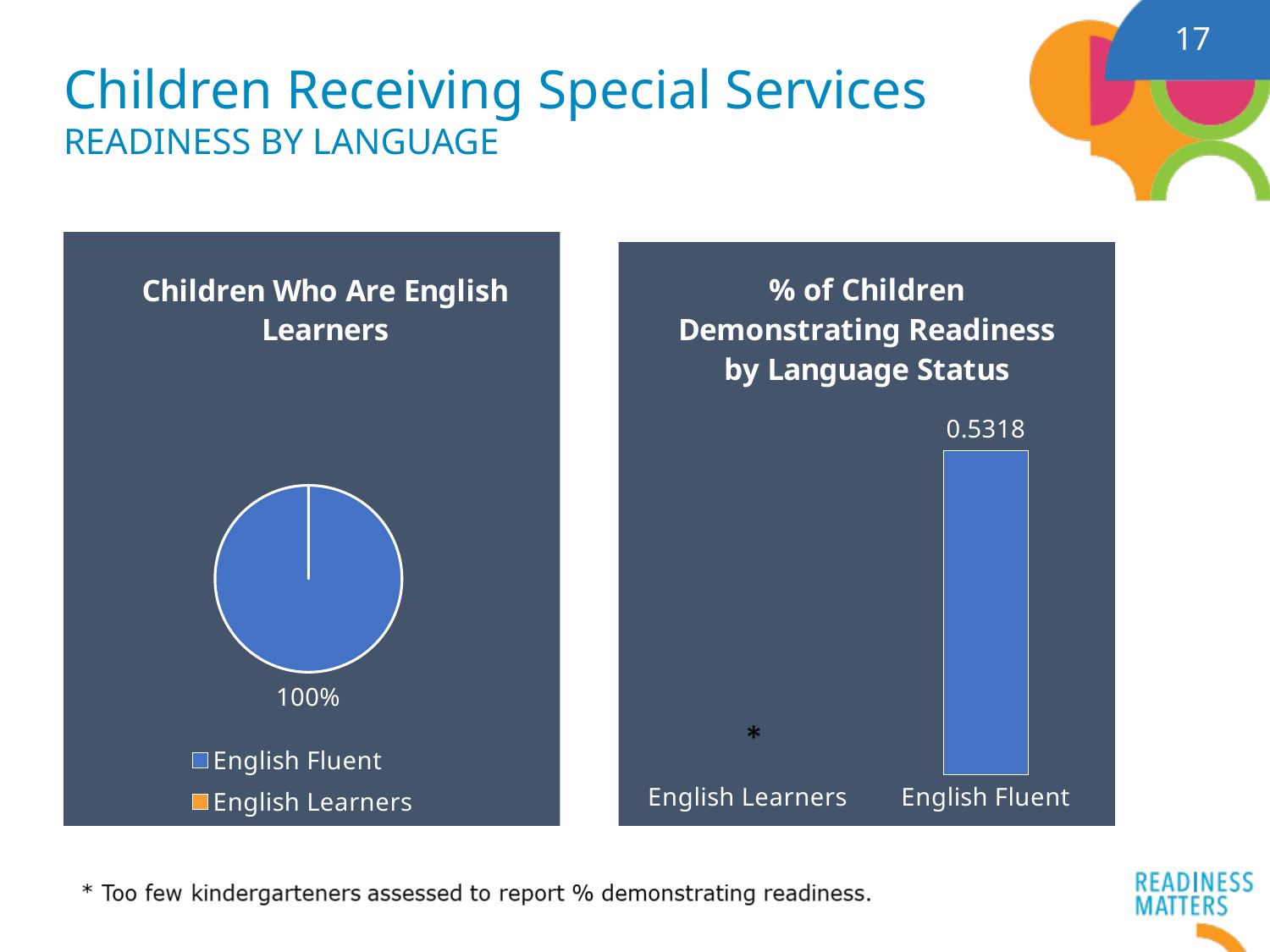
How many categories are shown on the x axis of the '% of Children Demonstrating Readiness by Language Status' chart? 2 In the '% of Children Demonstrating Readiness by Language Status' chart, which category has a plotted bar? English Fluent According to the footnote, why is no value reported for English Learners in the right-hand chart? Too few kindergarteners assessed to report % demonstrating readiness. In the 'Children Who Are English Learners' chart, which category makes up the entire pie? English Fluent In the '% of Children Demonstrating Readiness by Language Status' chart, what is shown in place of a bar for English Learners? * In the 'Children Who Are English Learners' chart, what share of the pie is English Fluent? 100% What kind of chart is '% of Children Demonstrating Readiness by Language Status'? bar chart In the 'Children Who Are English Learners' chart, which legend entry is shown in orange? English Learners What kind of chart is 'Children Who Are English Learners'? pie chart How many entries does the legend of the 'Children Who Are English Learners' chart list? 2 In the '% of Children Demonstrating Readiness by Language Status' chart, what is the value for English Fluent? 0.5318